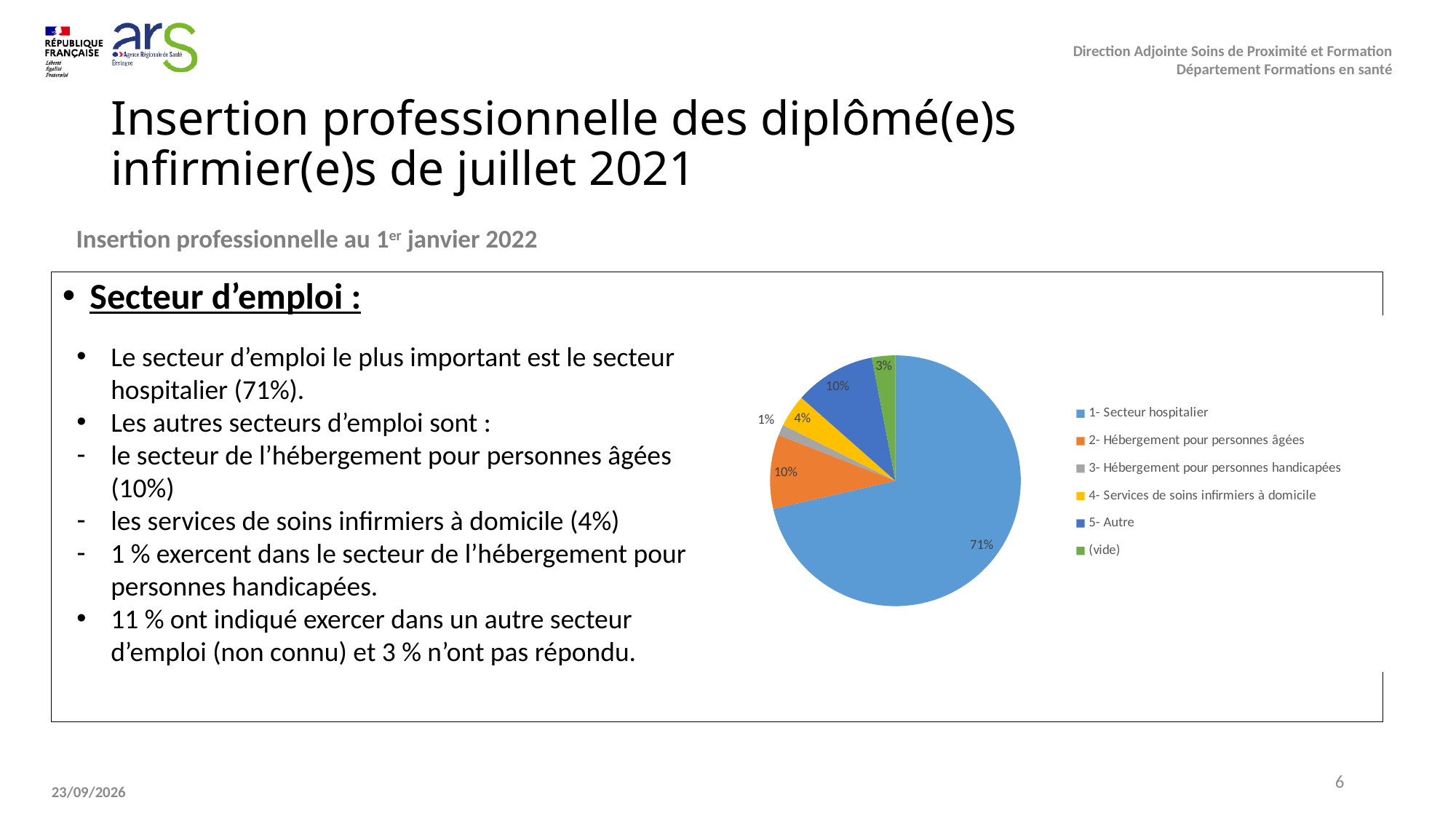
What share of the pie does "1- Secteur hospitalier" represent? 71% What percentage is shown for "2- Hébergement pour personnes âgées"? 10% What percentage is shown for "3- Hébergement pour personnes handicapées"? 1% Which category has the smallest slice of the pie? 3- Hébergement pour personnes handicapées Which category has the largest slice of the pie? 1- Secteur hospitalier What kind of chart is shown on the slide? pie chart What colour is the slice for "4- Services de soins infirmiers à domicile"? yellow What percentage is shown for the "(vide)" slice? 3% What percentage is shown for "4- Services de soins infirmiers à domicile"? 4% What is the difference in percentage points between "1- Secteur hospitalier" and "5- Autre"? 61 How many slices does the pie chart have? 6 Which is larger: the slice for "4- Services de soins infirmiers à domicile" or the slice for "(vide)"? 4- Services de soins infirmiers à domicile